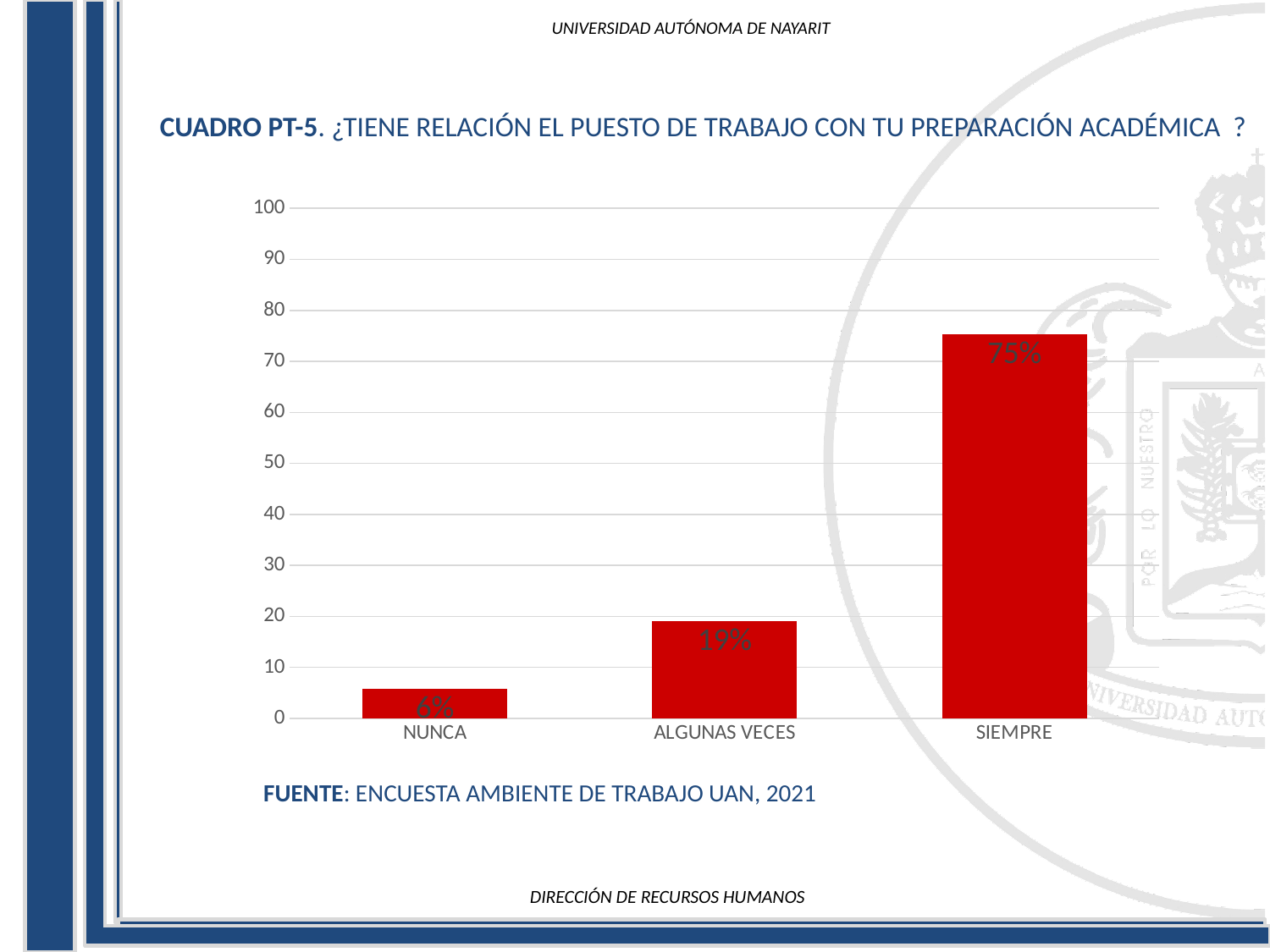
What is the difference between the values for SIEMPRE and ALGUNAS VECES? 56% What is the value for NUNCA? 6% Which is larger, the value for ALGUNAS VECES or the value for NUNCA? ALGUNAS VECES How many categories are shown on the x axis? 3 What kind of chart is shown on the slide? bar chart Which category has the highest value? SIEMPRE What is the value for ALGUNAS VECES? 19% What is the value for SIEMPRE? 75% Which category has the lowest value? NUNCA Is the value for SIEMPRE greater or less than 70? greater Do the values rise or fall from left to right along the x axis? rise What is the difference between the values for ALGUNAS VECES and NUNCA? 13%